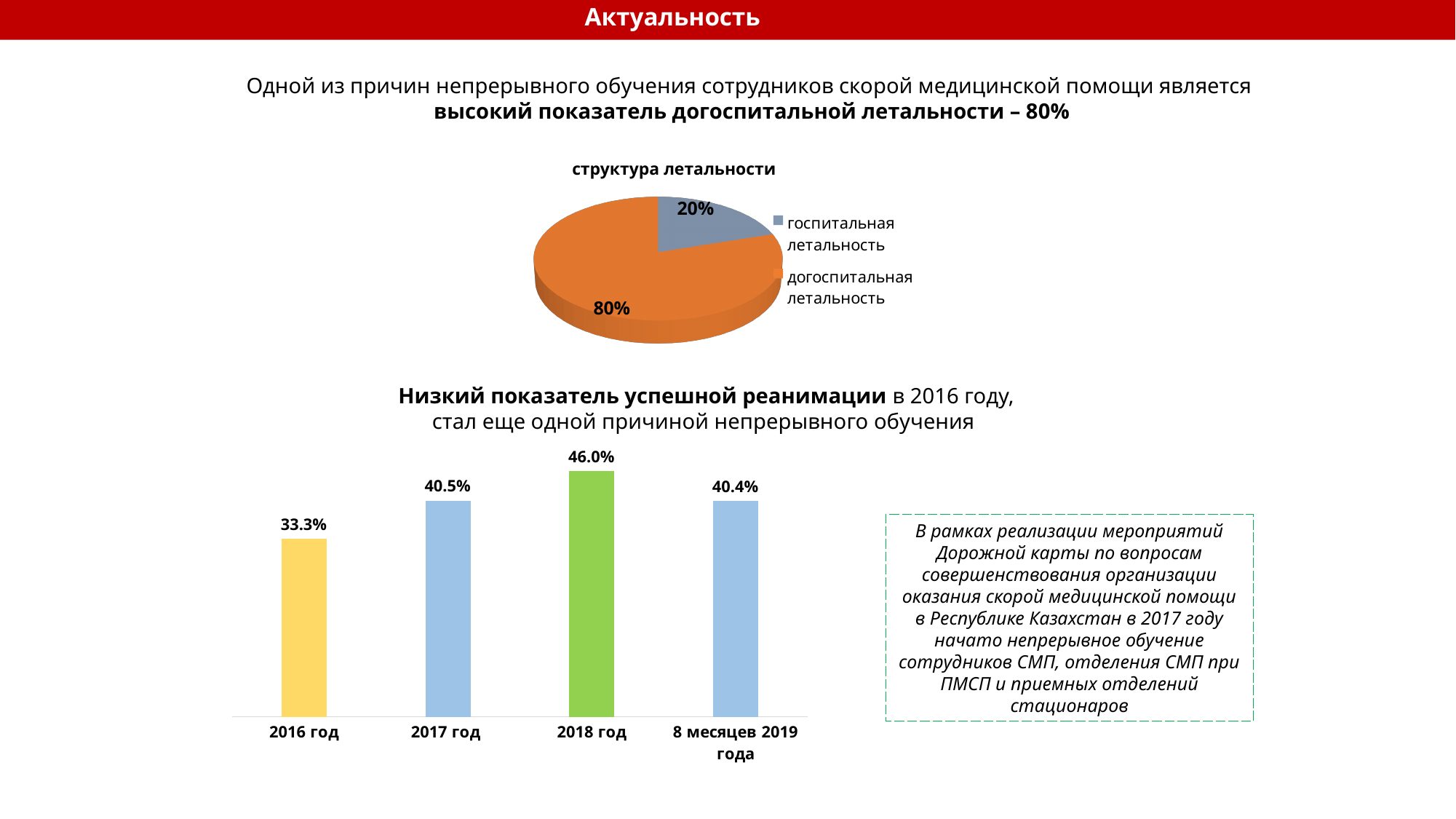
What kind of chart is the upper chart titled "структура летальности"? pie chart In the pie chart titled "структура летальности", what share is labelled for догоспитальная летальность? 80% In the bar chart at the bottom of the slide, what is the difference between the values for 2018 год and 2016 год? 12.7% In the pie chart titled "структура летальности", how many slices does the pie have? 2 In the pie chart titled "структура летальности", which slice is larger: госпитальная летальность or догоспитальная летальность? догоспитальная летальность In the bar chart at the bottom of the slide, which category has the lowest value? 2016 год In the bar chart at the bottom of the slide, which category has the highest value? 2018 год In the pie chart titled "структура летальности", what share is labelled for госпитальная летальность? 20% In the bar chart at the bottom of the slide, what is the value for 2016 год? 33.3% In the bar chart at the bottom of the slide, what is the value for 8 месяцев 2019 года? 40.4% In the bar chart at the bottom of the slide, how many bars are shown? 4 In the bar chart at the bottom of the slide, what is the value for 2017 год? 40.5%